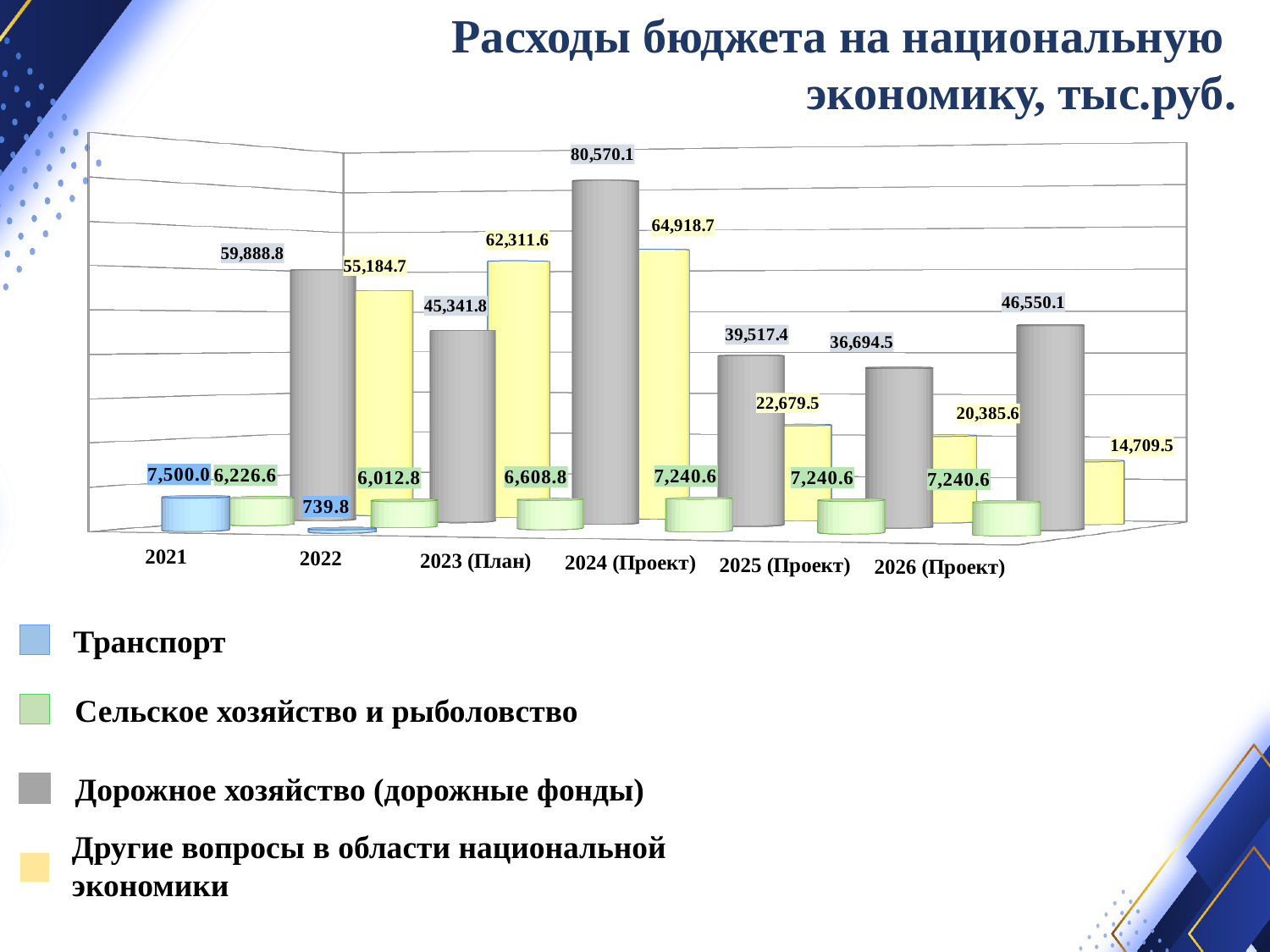
What is the value for Сельское хозяйство и рыболовство in 2025 (Проект)? 7,240.6 What is the difference between the Дорожное хозяйство (дорожные фонды) values for 2023 (План) and 2024 (Проект)? 41,052.7 In 2022, which is larger: Дорожное хозяйство (дорожные фонды) or Другие вопросы в области национальной экономики? Другие вопросы в области национальной экономики What is the value for Транспорт in 2022? 739.8 Do the values for Другие вопросы в области национальной экономики rise or fall from 2024 (Проект) to 2026 (Проект)? Fall What is the title of the chart? Расходы бюджета на национальную экономику, тыс.руб. How many series does the legend list? 4 How many year categories are shown on the x axis? 6 In which year is the value for Дорожное хозяйство (дорожные фонды) the highest? 2023 (План) What kind of chart is shown on the slide? Bar chart What is the value for Другие вопросы в области национальной экономики in 2026 (Проект)? 14,709.5 What is the value for Дорожное хозяйство (дорожные фонды) in 2023 (План)? 80,570.1